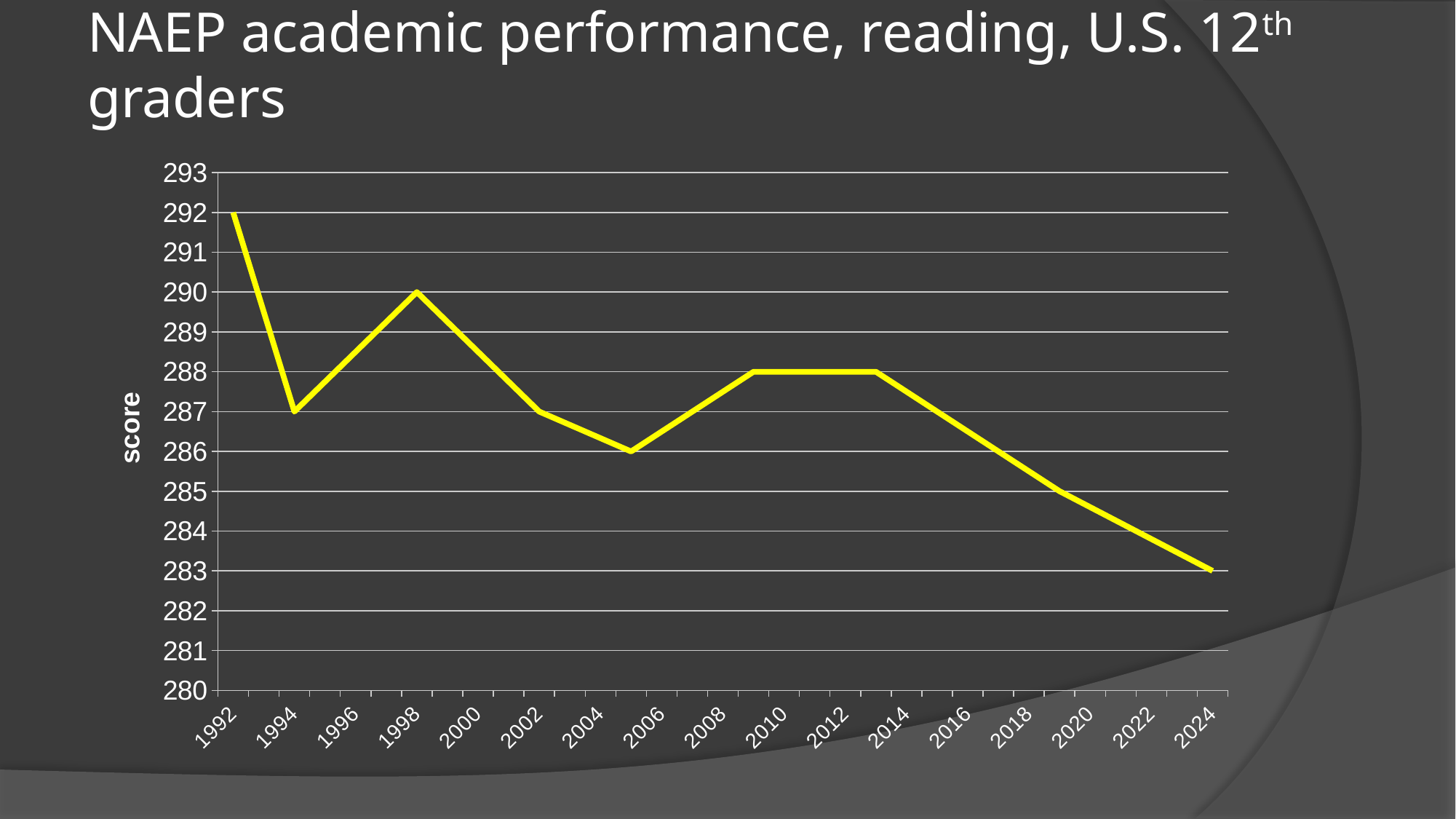
What is the reading score for 1998? 290 Is the value for 2022 greater or less than 285? less In which year is the reading score highest? 1992 What kind of chart is shown on the slide? line chart What is the reading score for 1992? 292 In which year is the reading score lowest? 2024 What is the label on the vertical axis? score Which year has the higher score, 1994 or 1998? 1998 What is the reading score for 1994? 287 Overall, do the scores rise or fall from 1992 to 2024? fall What is the difference between the 1992 score and the 2024 score? 9 What is the reading score for 2024? 283